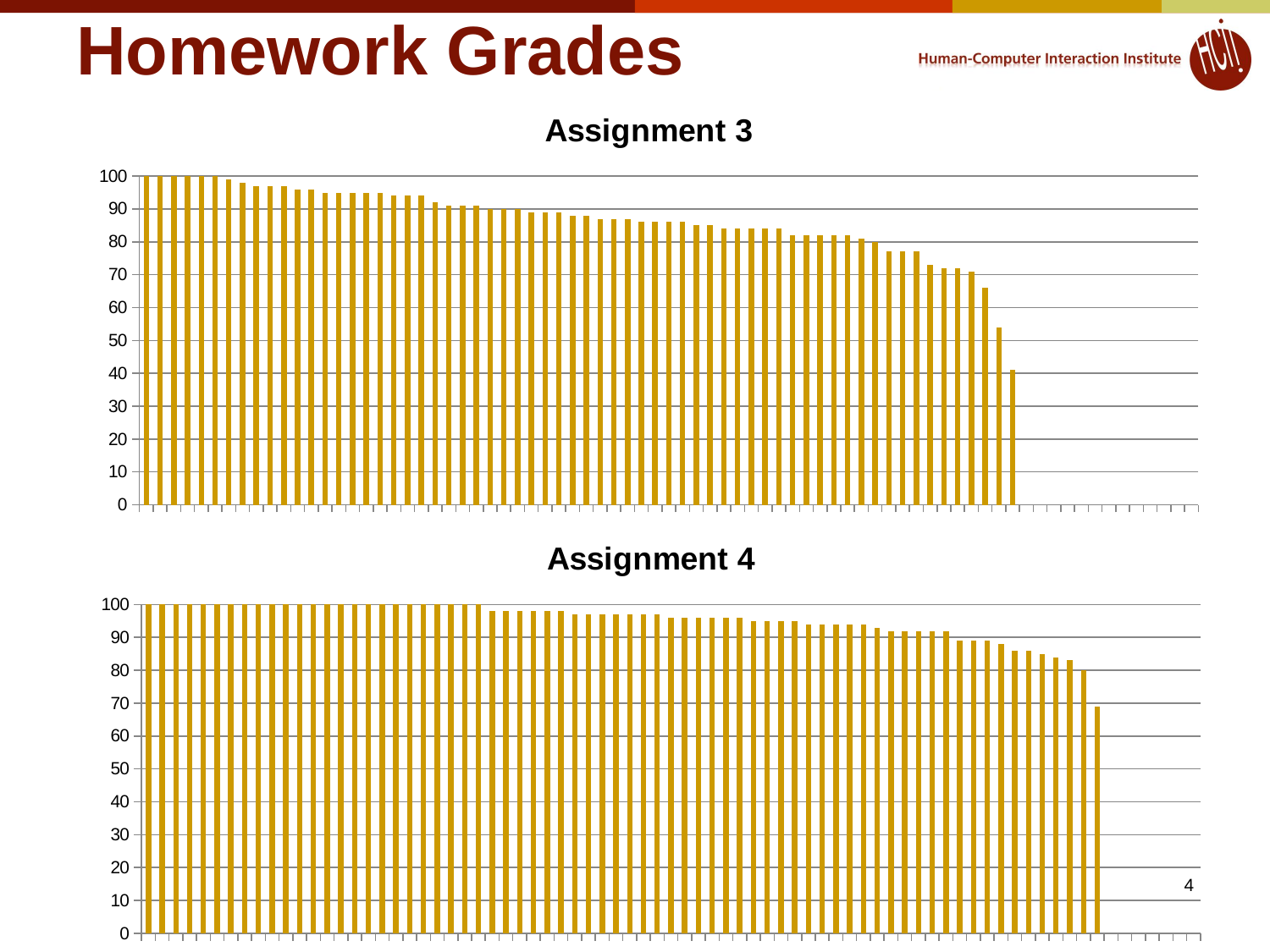
In the Assignment 4 chart, do the bar values rise or fall from left to right? fall In the Assignment 3 chart, is the value of the second-to-last bar greater or less than 60? less In the Assignment 3 chart, what is the value of the tallest bar? 100 What is the title of the upper chart on the slide? Assignment 3 In the Assignment 3 chart, is the value of the rightmost bar greater or less than 50? less What kind of chart is the Assignment 4 chart? bar chart What is the highest value shown on the y axis of the Assignment 4 chart? 100 In the Assignment 4 chart, what is the value of the tallest bar? 100 In the Assignment 4 chart, is the value of the rightmost bar greater or less than 80? less In the Assignment 3 chart, do the bar values rise or fall from left to right? fall Which chart has the lower rightmost bar, Assignment 3 or Assignment 4? Assignment 3 What kind of chart is the Assignment 3 chart? bar chart